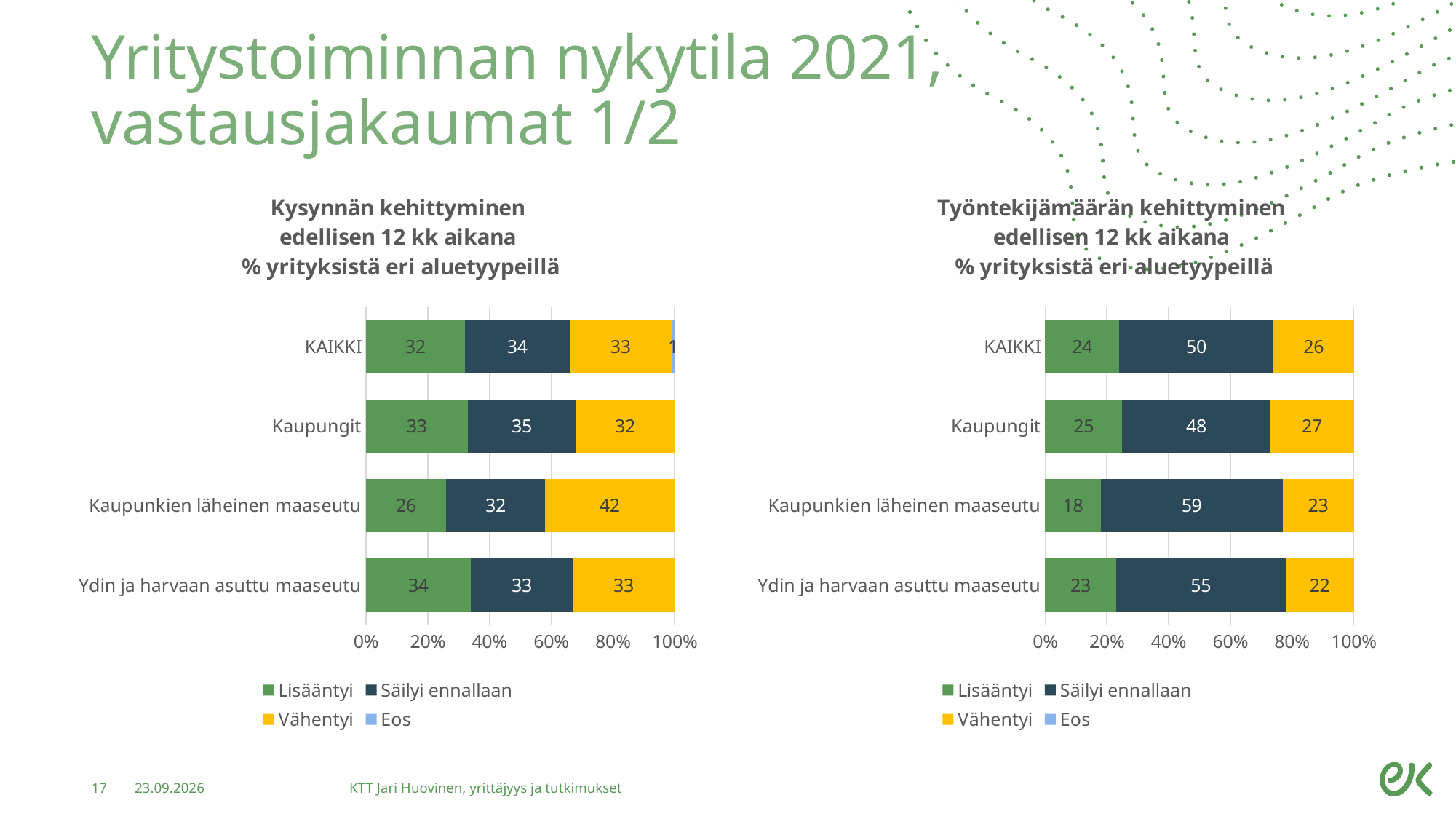
In the chart titled "Työntekijämäärän kehittyminen edellisen 12 kk aikana", what is the difference between the Säilyi ennallaan values for Kaupunkien läheinen maaseutu and Kaupungit? 11 In the chart titled "Työntekijämäärän kehittyminen edellisen 12 kk aikana", what is the Säilyi ennallaan value for KAIKKI? 50 In the chart titled "Työntekijämäärän kehittyminen edellisen 12 kk aikana", which category has the lowest Lisääntyi value? Kaupunkien läheinen maaseutu How many series does the legend list for the chart titled "Työntekijämäärän kehittyminen edellisen 12 kk aikana"? 4 In the chart titled "Kysynnän kehittyminen edellisen 12 kk aikana", what is the Vähentyi value for Kaupunkien läheinen maaseutu? 42 In the chart titled "Työntekijämäärän kehittyminen edellisen 12 kk aikana", which is larger: the Vähentyi value for Kaupungit or for Ydin ja harvaan asuttu maaseutu? Kaupungit What kind of chart is the chart titled "Kysynnän kehittyminen edellisen 12 kk aikana"? Stacked bar chart In the chart titled "Kysynnän kehittyminen edellisen 12 kk aikana", what is the difference between the Vähentyi values for Kaupunkien läheinen maaseutu and Kaupungit? 10 How many categories are shown on the y axis of the chart titled "Kysynnän kehittyminen edellisen 12 kk aikana"? 4 In the chart titled "Työntekijämäärän kehittyminen edellisen 12 kk aikana", which colour represents the Säilyi ennallaan series? Dark blue In the chart titled "Kysynnän kehittyminen edellisen 12 kk aikana", which category has the highest Vähentyi value? Kaupunkien läheinen maaseutu In the chart titled "Työntekijämäärän kehittyminen edellisen 12 kk aikana", what is the Lisääntyi value for Ydin ja harvaan asuttu maaseutu? 23